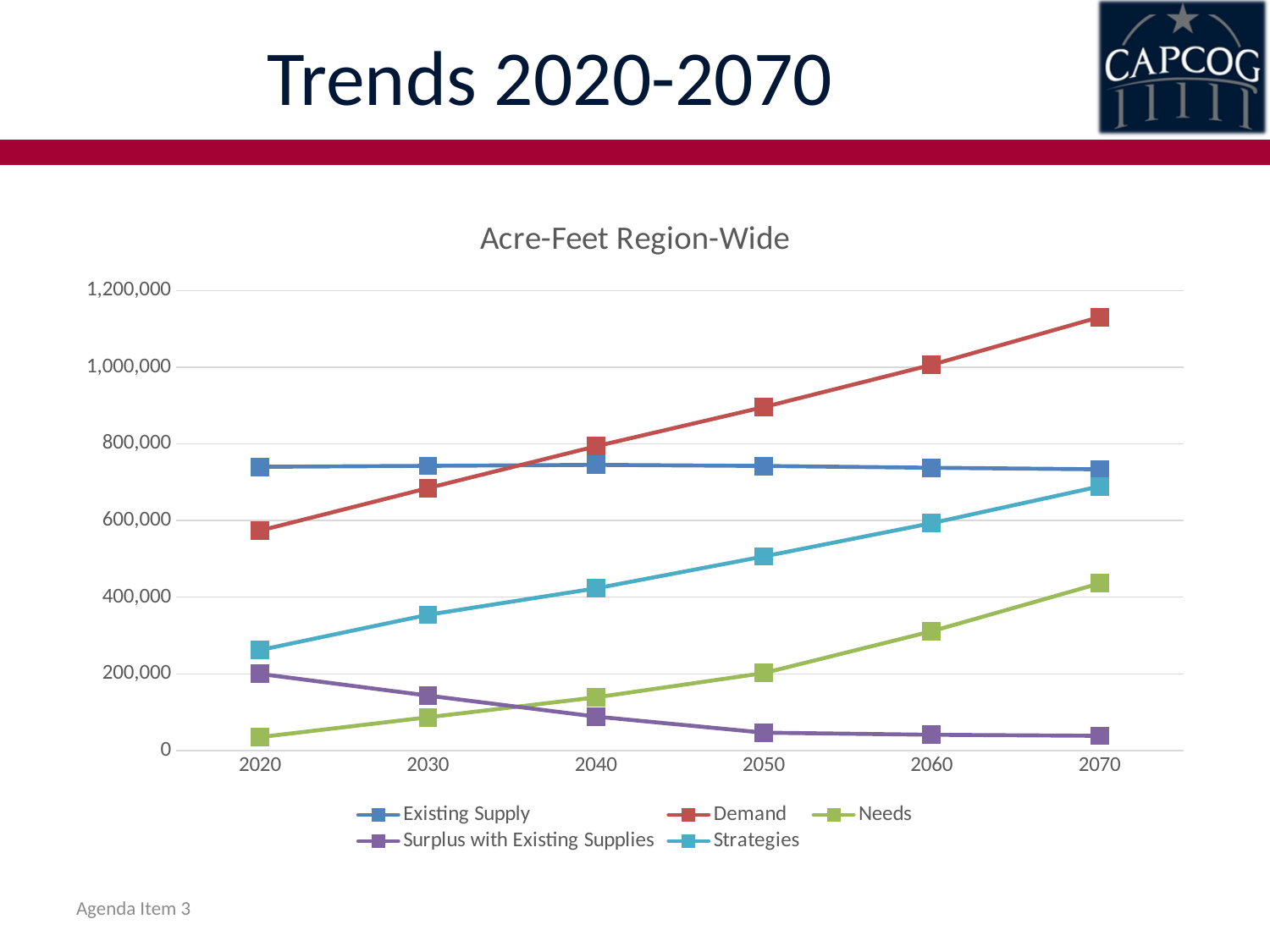
What is the title of the chart? Acre-Feet Region-Wide How many series does the chart legend list? 5 Is the Demand value for 2020 greater or less than 600,000? less Is the Demand value for 2070 greater or less than 1,000,000? greater What kind of chart is shown on the slide? line chart How many years are plotted along the x axis? 6 Is the Strategies value for 2070 greater or less than 800,000? less Does the Surplus with Existing Supplies series rise or fall from 2020 to 2070? fall Which series has the lowest value in 2070? Surplus with Existing Supplies Which series has the highest value in 2070? Demand In 2020, which is larger: Existing Supply or Demand? Existing Supply